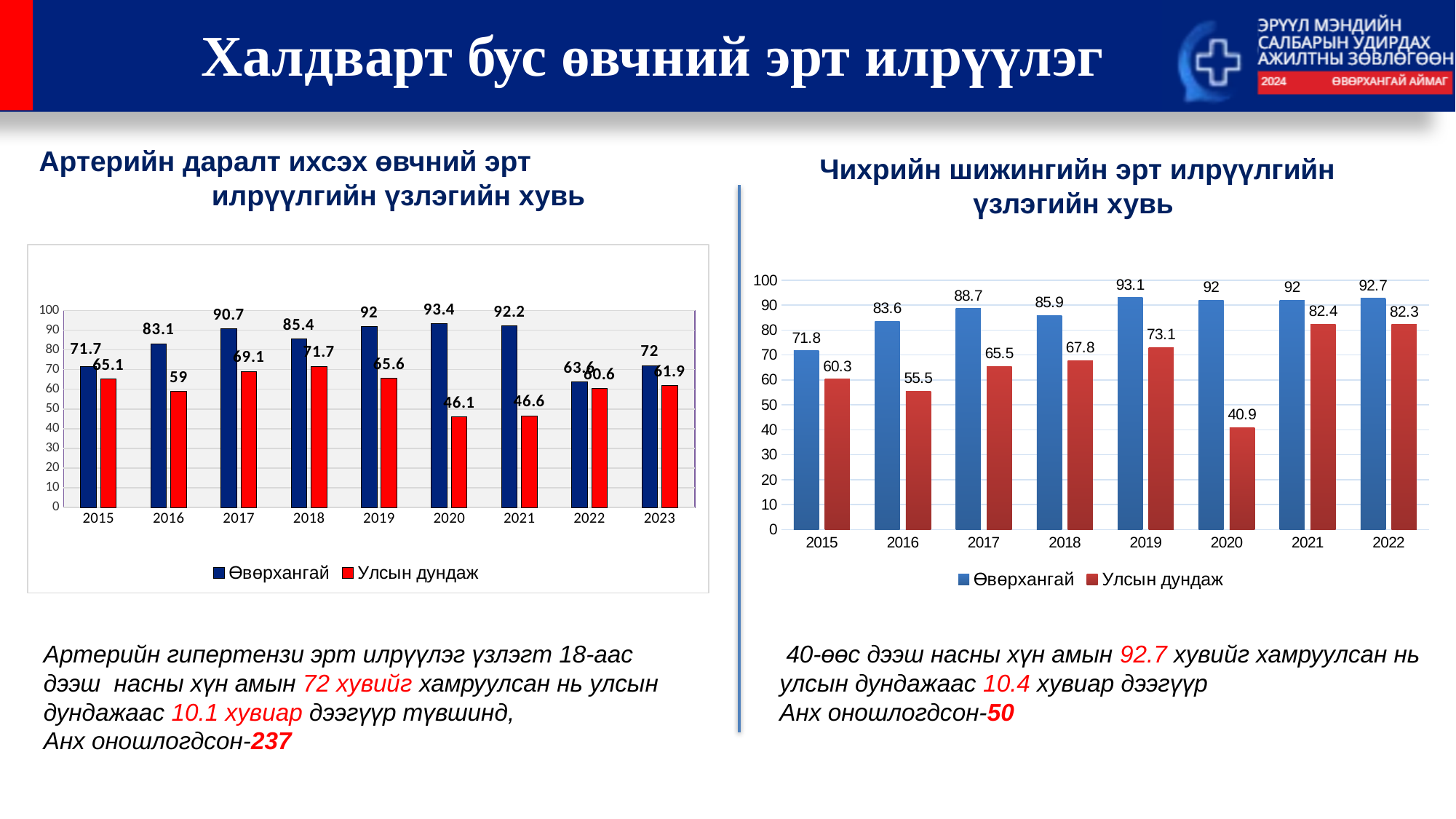
What type of chart is the left chart (Артерийн даралт ихсэх өвчний эрт илрүүлгийн үзлэгийн хувь)? Bar chart In the left chart (Артерийн даралт ихсэх өвчний эрт илрүүлгийн үзлэгийн хувь), how many years are shown on the x axis? 9 In the left chart (Артерийн даралт ихсэх өвчний эрт илрүүлгийн үзлэгийн хувь), what is the difference between Өвөрхангай and Улсын дундаж in 2023? 10.1 In the right chart (Чихрийн шижингийн эрт илрүүлгийн үзлэгийн хувь), what is the value for Өвөрхангай in 2019? 93.1 In the right chart (Чихрийн шижингийн эрт илрүүлгийн үзлэгийн хувь), how many series does the legend list? 2 In the left chart (Артерийн даралт ихсэх өвчний эрт илрүүлгийн үзлэгийн хувь), which year has the lowest Улсын дундаж value? 2020 In the right chart (Чихрийн шижингийн эрт илрүүлгийн үзлэгийн хувь), what is the difference between Өвөрхангай and Улсын дундаж in 2022? 10.4 In the left chart (Артерийн даралт ихсэх өвчний эрт илрүүлгийн үзлэгийн хувь), what is the value for Өвөрхангай in 2020? 93.4 In the right chart (Чихрийн шижингийн эрт илрүүлгийн үзлэгийн хувь), which year has the highest Өвөрхангай value? 2019 In the right chart (Чихрийн шижингийн эрт илрүүлгийн үзлэгийн хувь), what is the value for Улсын дундаж in 2020? 40.9 In the left chart (Артерийн даралт ихсэх өвчний эрт илрүүлгийн үзлэгийн хувь), what is the value for Улсын дундаж in 2021? 46.6 In the right chart (Чихрийн шижингийн эрт илрүүлгийн үзлэгийн хувь), which is larger: Улсын дундаж in 2016 or Улсын дундаж in 2017? 2017